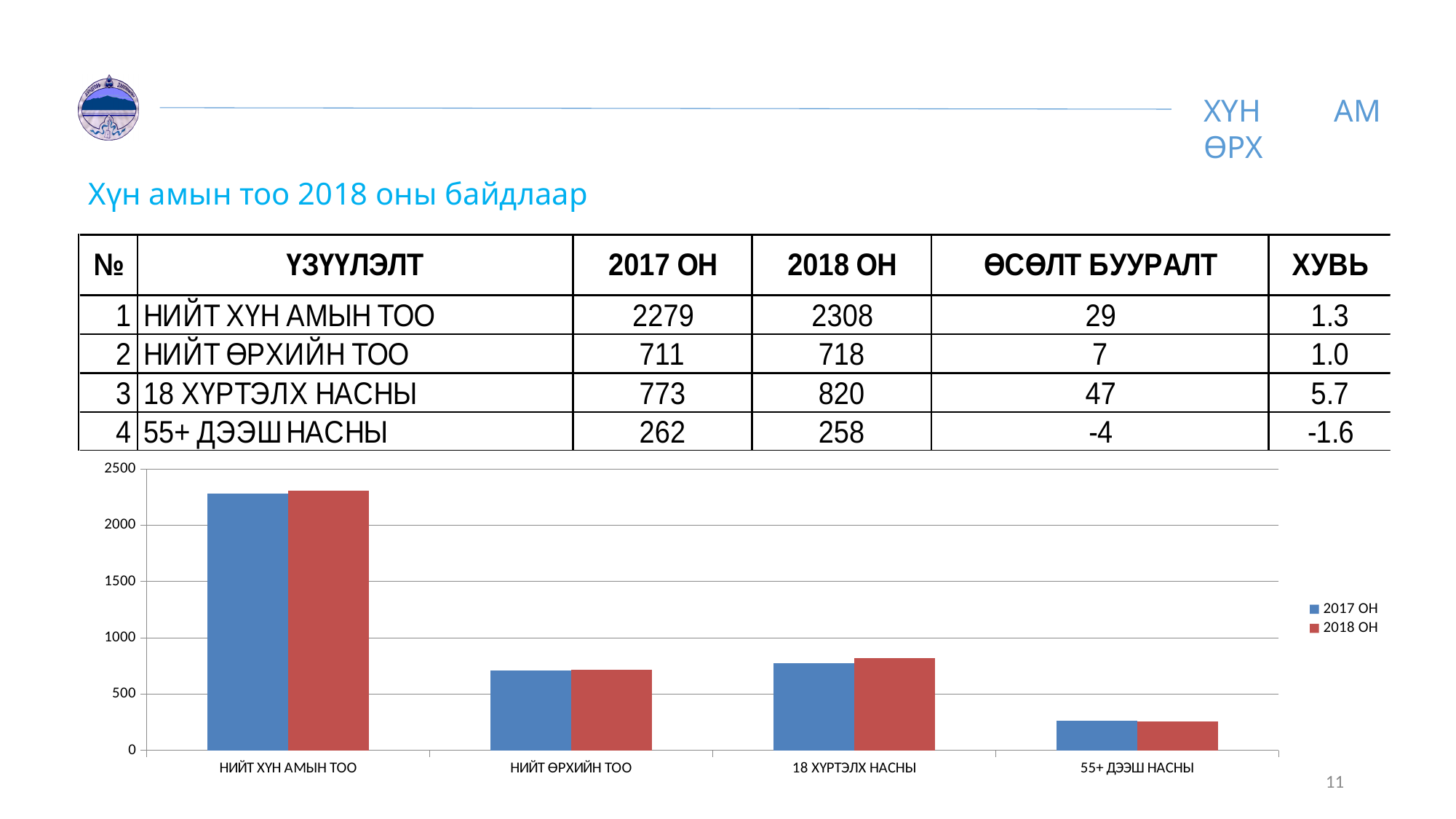
According to the slide, what is the 2017 ОН value for 18 ХҮРТЭЛХ НАСНЫ? 773 Is the 2018 ОН value for НИЙТ ХҮН АМЫН ТОО greater or less than 2000? greater Which is larger for 18 ХҮРТЭЛХ НАСНЫ: the 2017 ОН bar or the 2018 ОН bar? 2018 ОН What kind of chart is shown on the slide? bar chart Is the 2018 ОН value for 18 ХҮРТЭЛХ НАСНЫ greater or less than 1000? less How many series does the chart legend list? 2 Which category has the highest bars in the chart? НИЙТ ХҮН АМЫН ТОО According to the slide, what is the 2018 ОН value for НИЙТ ХҮН АМЫН ТОО? 2308 What colour are the 2018 ОН bars in the chart? red Which category has the lowest bars in the chart? 55+ ДЭЭШ НАСНЫ How many categories are shown on the x axis of the chart? 4 Is the 2017 ОН value for 55+ ДЭЭШ НАСНЫ greater or less than 500? less